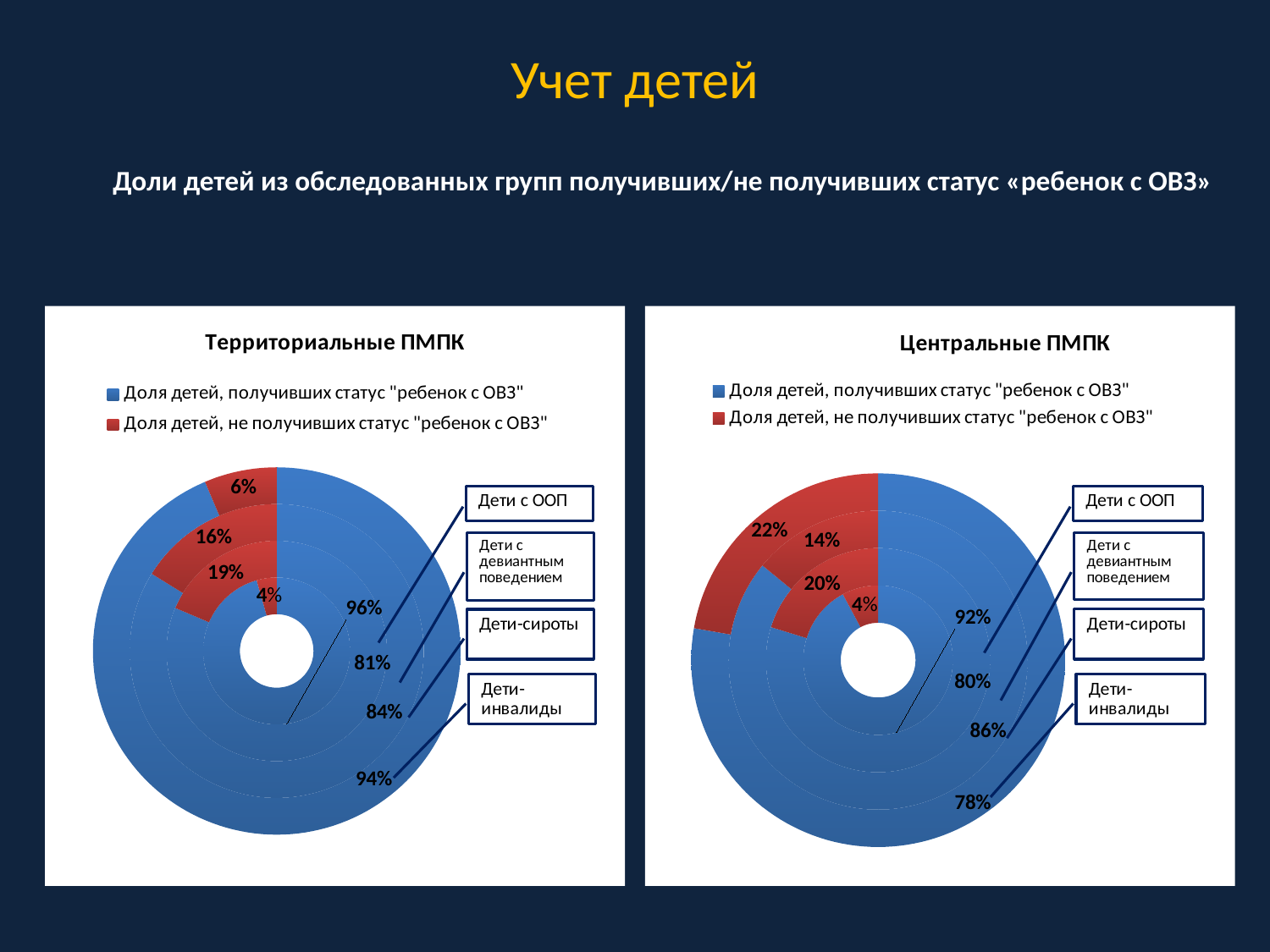
In the "Территориальные ПМПК" chart, what share of children with deviant behaviour (Дети с девиантным поведением) did not receive the status "ребенок с ОВЗ"? 19% In the "Центральные ПМПК" chart, what share of orphans (Дети-сироты) did not receive the status "ребенок с ОВЗ"? 14% In the "Центральные ПМПК" chart, what is the difference between the share of children with deviant behaviour who received the status and the share who did not? 60% In the "Территориальные ПМПК" chart, which group has the highest share of children who received the status "ребенок с ОВЗ"? Дети с ООП How many series does the legend of the "Территориальные ПМПК" chart list? 2 In the "Центральные ПМПК" chart, what share of children with disabilities (Дети-инвалиды) received the status "ребенок с ОВЗ"? 78% In the "Центральные ПМПК" chart, which group has the lowest share of children who received the status "ребенок с ОВЗ"? Дети-инвалиды In the "Территориальные ПМПК" chart, which colour represents the share of children who did not receive the status "ребенок с ОВЗ"? Red Which chart shows a larger share of children with disabilities (Дети-инвалиды) receiving the status "ребенок с ОВЗ": "Территориальные ПМПК" or "Центральные ПМПК"? Территориальные ПМПК In the "Территориальные ПМПК" chart, what share of children with ООП received the status "ребенок с ОВЗ"? 96% In the "Территориальные ПМПК" chart, what is the difference between the share of orphans (Дети-сироты) who received the status and the share who did not? 68% What type of chart is the "Центральные ПМПК" chart? Doughnut chart